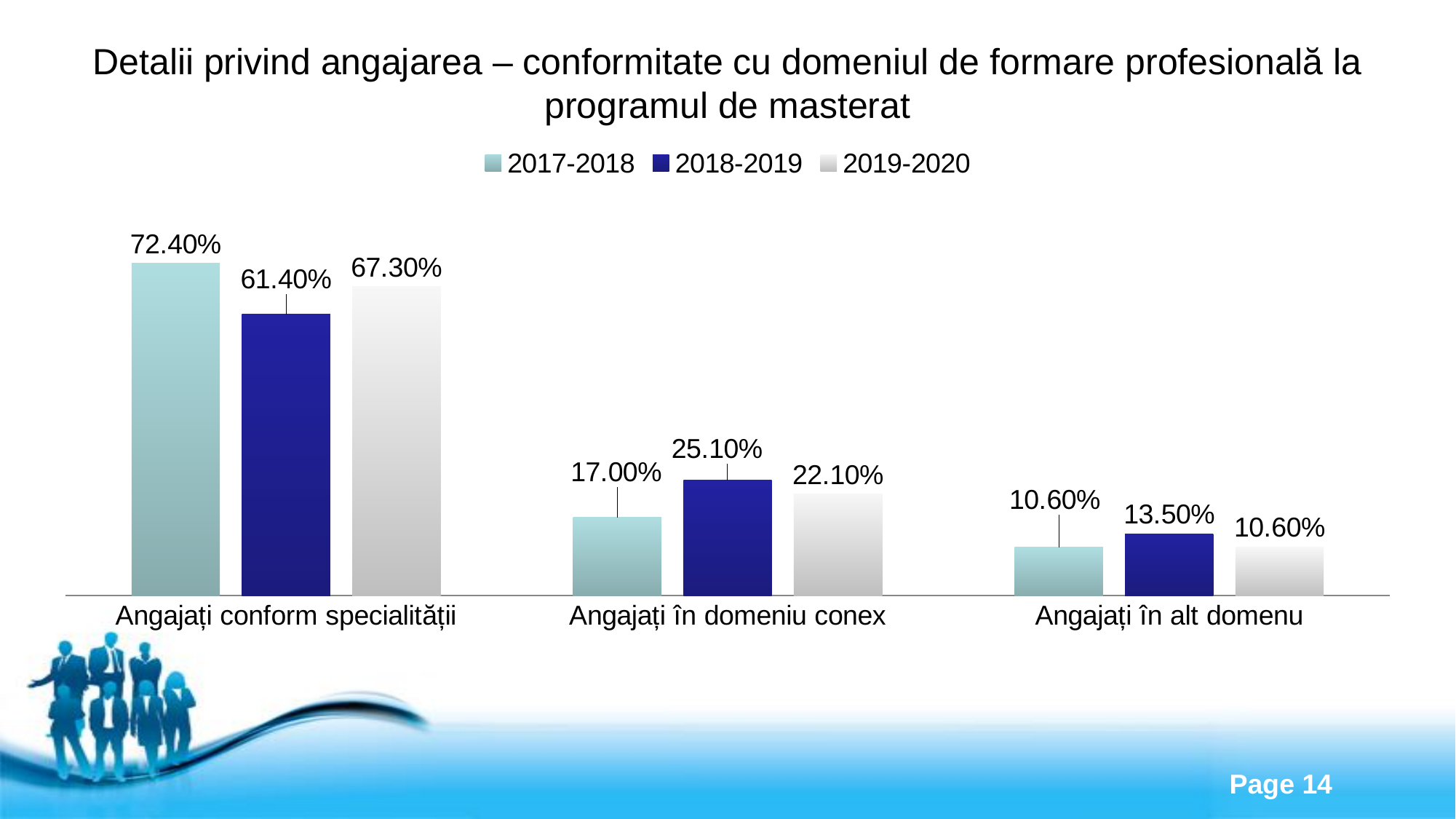
Which series is shown in dark blue in the legend? 2018-2019 What is the difference between the 2017-2018 and 2018-2019 values in the 'Angajați conform specialității' category? 11.00% How many series does the legend list? 3 Which series has the highest value in the 'Angajați conform specialității' category? 2017-2018 What is the value for 2018-2019 in the 'Angajați în domeniu conex' category? 25.10% What kind of chart is shown on the slide? Bar chart How many categories are shown on the x axis? 3 Which is larger: the 2019-2020 value for 'Angajați conform specialității' or the 2018-2019 value for 'Angajați conform specialității'? 2019-2020 What is the value for 2017-2018 in the 'Angajați conform specialității' category? 72.40% What is the value for 2019-2020 in the 'Angajați în alt domenu' category? 10.60% Which series has the lowest value in the 'Angajați în domeniu conex' category? 2017-2018 What is the difference between the 2018-2019 and 2019-2020 values in the 'Angajați în domeniu conex' category? 3.00%